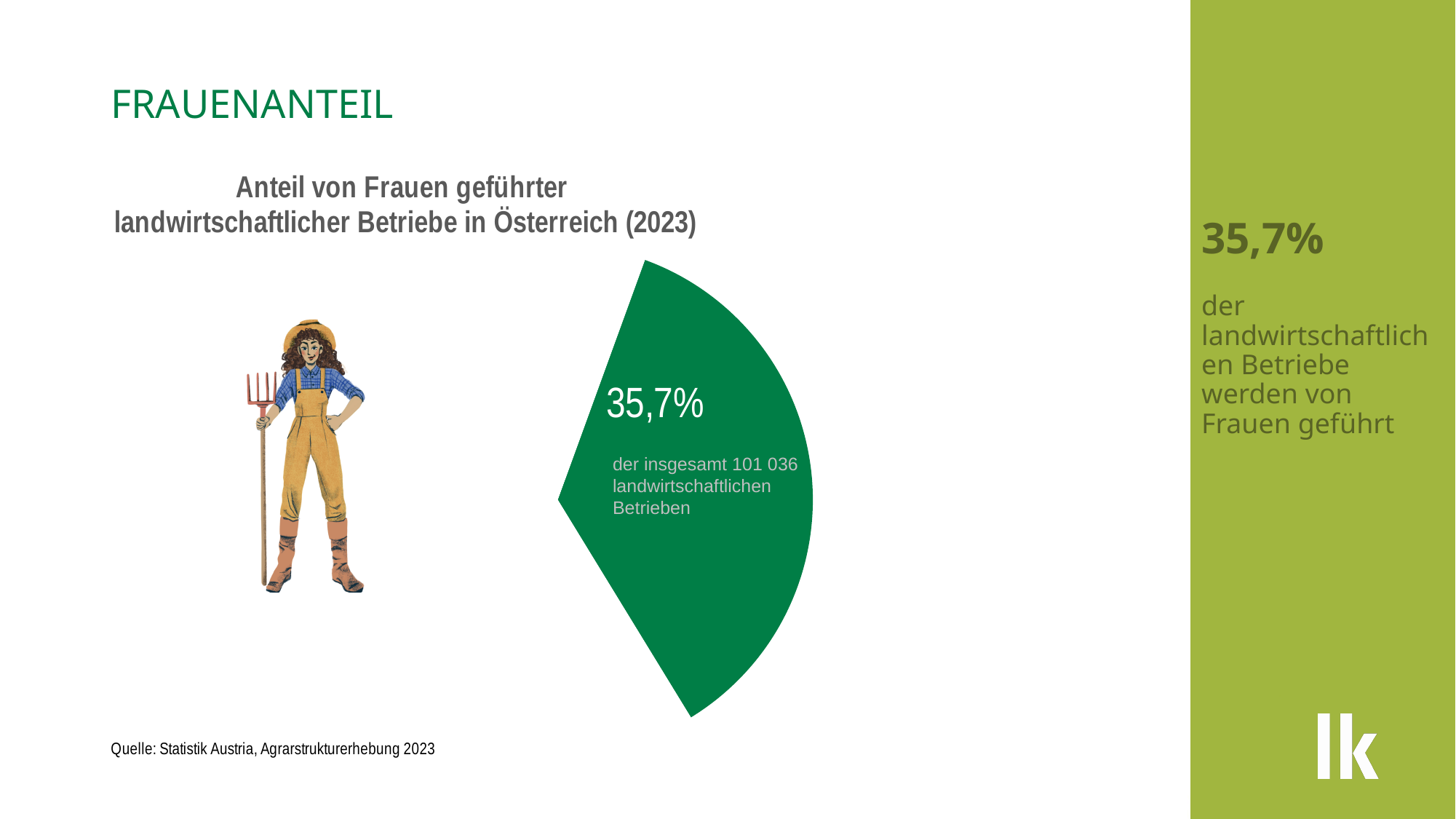
What colour is the slice representing women-led holdings in the pie chart? green What value is printed on the green slice of the pie chart? 35,7% According to the chart's label, how many agricultural holdings are there in total? 101 036 How many coloured slices are visible in the pie chart? 1 Is the share of women-led holdings shown in the chart greater or less than 50%? less What kind of chart is shown on the slide? pie chart What is the title of the chart? Anteil von Frauen geführter landwirtschaftlicher Betriebe in Österreich (2023) What share of agricultural holdings in Austria is led by women according to the chart? 35,7% Which year does the chart refer to? 2023 Is the share of women-led holdings shown in the chart greater or less than 30%? greater